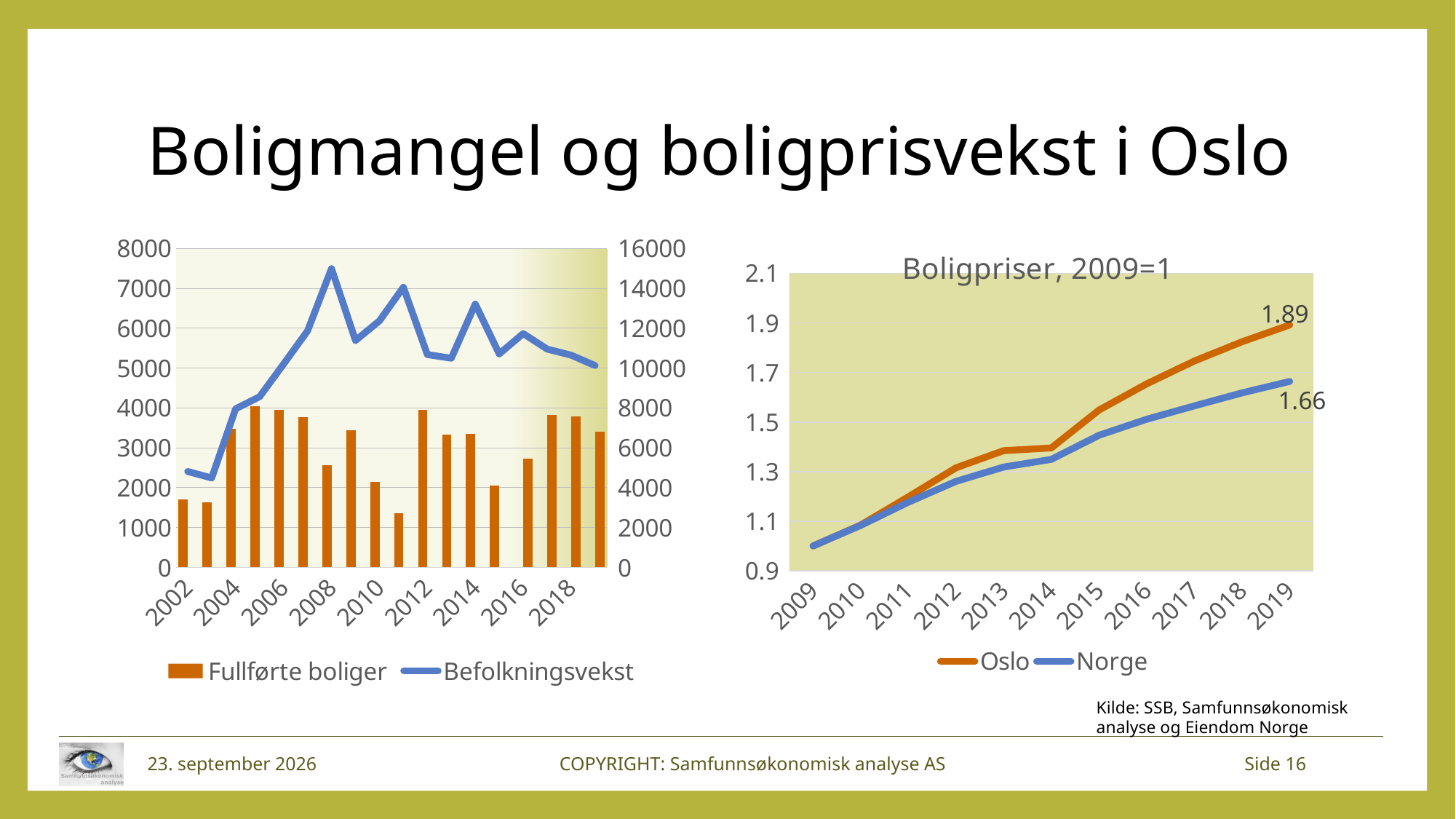
In the Boligpriser, 2009=1 chart, how many years are shown on the x axis? 11 In the Boligpriser, 2009=1 chart, which series has the higher value in 2019, Oslo or Norge? Oslo In the Boligpriser, 2009=1 chart, what is the difference between the Oslo and Norge values in 2019? 0.23 In the left chart, what kind of chart is used for the Fullførte boliger series? bar chart In the left chart, how many series does the legend list? 2 In the left chart, in which year is the Fullførte boliger bar lowest? 2011 In the Boligpriser, 2009=1 chart, what is the value for Oslo in 2019? 1.89 In the Boligpriser, 2009=1 chart, what is the value for Norge in 2019? 1.66 In the left chart, in which year does Befolkningsvekst reach its highest value? 2008 In the Boligpriser, 2009=1 chart, does the Oslo series rise or fall from 2009 to 2019? rise In the left chart, is the Fullførte boliger value for 2005 greater or less than 3000? greater In the Boligpriser, 2009=1 chart, how many series does the legend list? 2